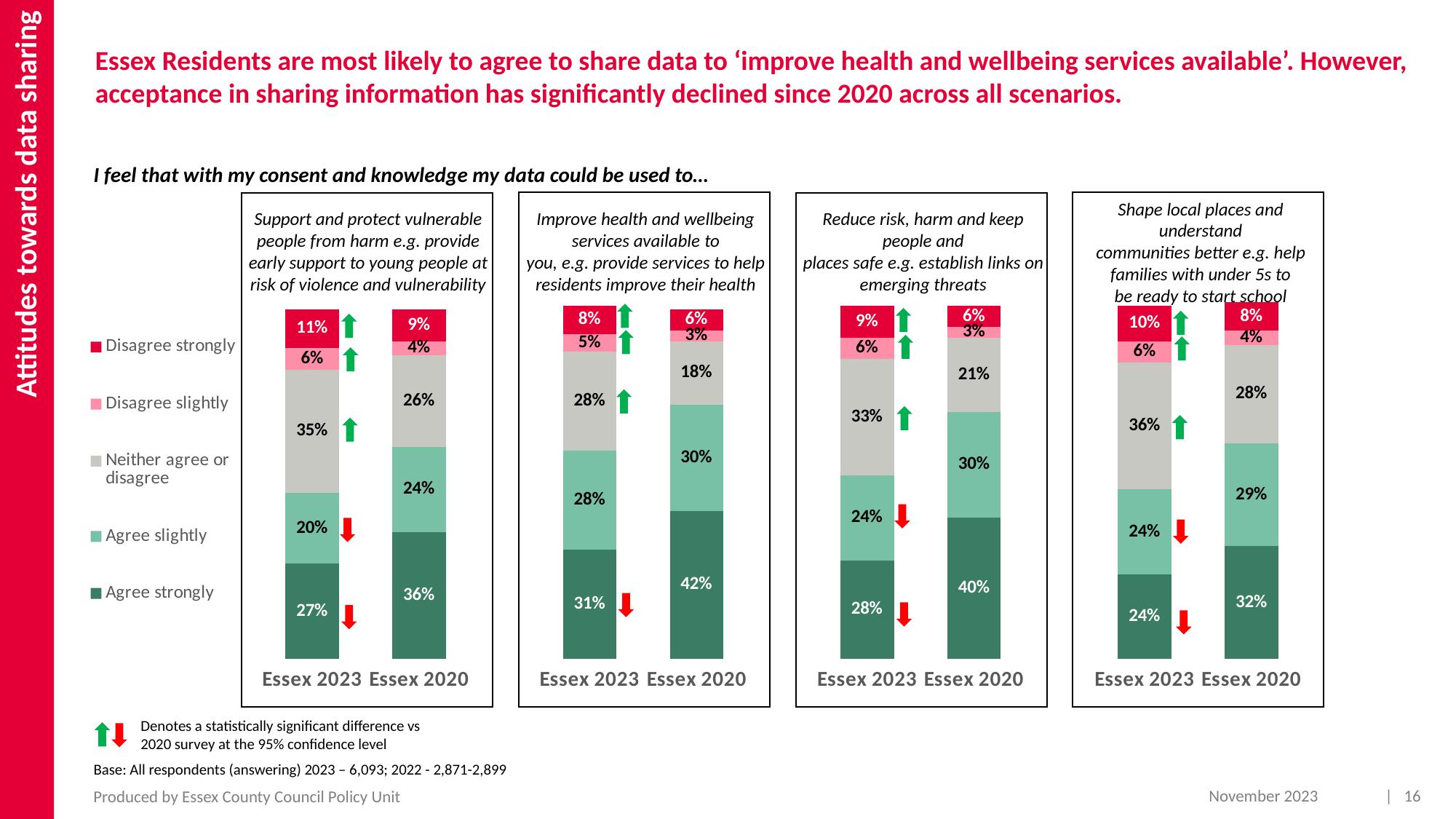
How many series does the legend on the left of the slide list? 5 What type of chart is used in each of the four panels on the slide? Stacked bar chart In the 'Improve health and wellbeing services available to you' chart, how much higher is the 'Agree strongly' share for Essex 2020 than for Essex 2023? 11 percentage points In the 'Support and protect vulnerable people from harm' chart, which bar has the larger 'Neither agree or disagree' share, Essex 2023 or Essex 2020? Essex 2023 In the 'Shape local places and understand communities better' chart, what is the 'Agree slightly' value for Essex 2020? 29% In the 'Support and protect vulnerable people from harm' chart, what is the 'Neither agree or disagree' value for Essex 2020? 26% In the 'Shape local places and understand communities better' chart, what is the difference between the 'Neither agree or disagree' values for Essex 2023 and Essex 2020? 8 percentage points In the 'Shape local places and understand communities better' chart, which response category has the smallest share for Essex 2020? Disagree slightly In the 'Improve health and wellbeing services available to you' chart, what percentage of Essex 2023 respondents agree strongly? 31% In the 'Reduce risk, harm and keep people and places safe' chart, which response category has the largest share for Essex 2020? Agree strongly How many bars are shown in the 'Improve health and wellbeing services available to you' chart? 2 In the 'Reduce risk, harm and keep people and places safe' chart, what percentage of Essex 2023 respondents disagree strongly? 9%